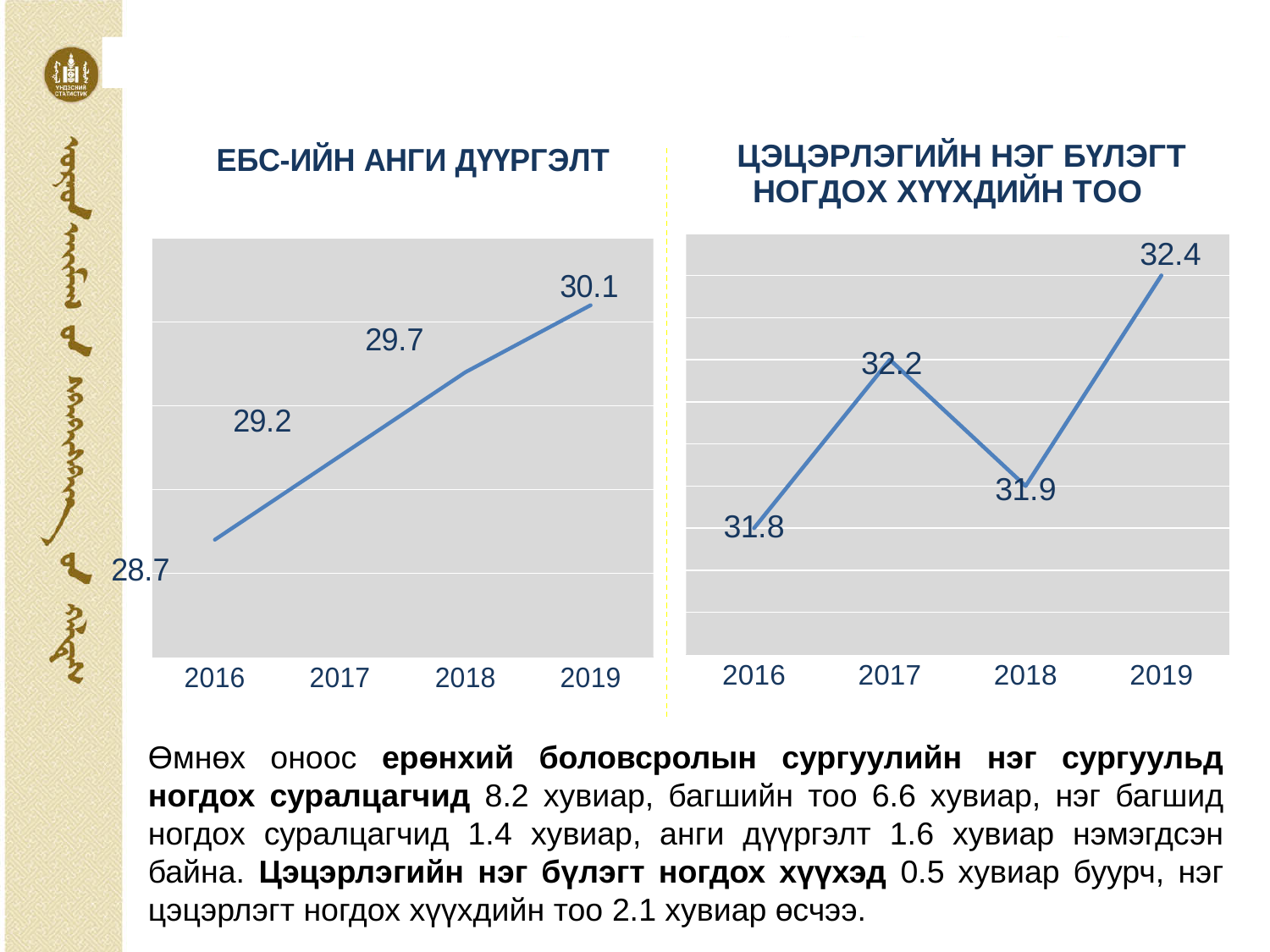
In the chart titled "ЦЭЦЭРЛЭГИЙН НЭГ БҮЛЭГТ НОГДОХ ХҮҮХДИЙН ТОО", what is the value for 2018? 31.9 How many years are plotted in the chart titled "ЦЭЦЭРЛЭГИЙН НЭГ БҮЛЭГТ НОГДОХ ХҮҮХДИЙН ТОО"? 4 In the chart titled "ЕБС-ИЙН АНГИ ДҮҮРГЭЛТ", do the values rise or fall from 2016 to 2019? rise In the chart titled "ЦЭЦЭРЛЭГИЙН НЭГ БҮЛЭГТ НОГДОХ ХҮҮХДИЙН ТОО", what is the value for 2017? 32.2 In the chart titled "ЦЭЦЭРЛЭГИЙН НЭГ БҮЛЭГТ НОГДОХ ХҮҮХДИЙН ТОО", which year has the highest value? 2019 In the chart titled "ЦЭЦЭРЛЭГИЙН НЭГ БҮЛЭГТ НОГДОХ ХҮҮХДИЙН ТОО", which is larger, the value for 2017 or the value for 2018? 2017 In the chart titled "ЦЭЦЭРЛЭГИЙН НЭГ БҮЛЭГТ НОГДОХ ХҮҮХДИЙН ТОО", which year has the lowest value? 2016 In the chart titled "ЕБС-ИЙН АНГИ ДҮҮРГЭЛТ", what is the value for 2019? 30.1 What kind of chart is the one titled "ЕБС-ИЙН АНГИ ДҮҮРГЭЛТ"? line chart In the chart titled "ЕБС-ИЙН АНГИ ДҮҮРГЭЛТ", which year has the lowest value? 2016 In the chart titled "ЕБС-ИЙН АНГИ ДҮҮРГЭЛТ", what is the difference between the 2019 and 2016 values? 1.4 In the chart titled "ЕБС-ИЙН АНГИ ДҮҮРГЭЛТ", what is the value for 2016? 28.7